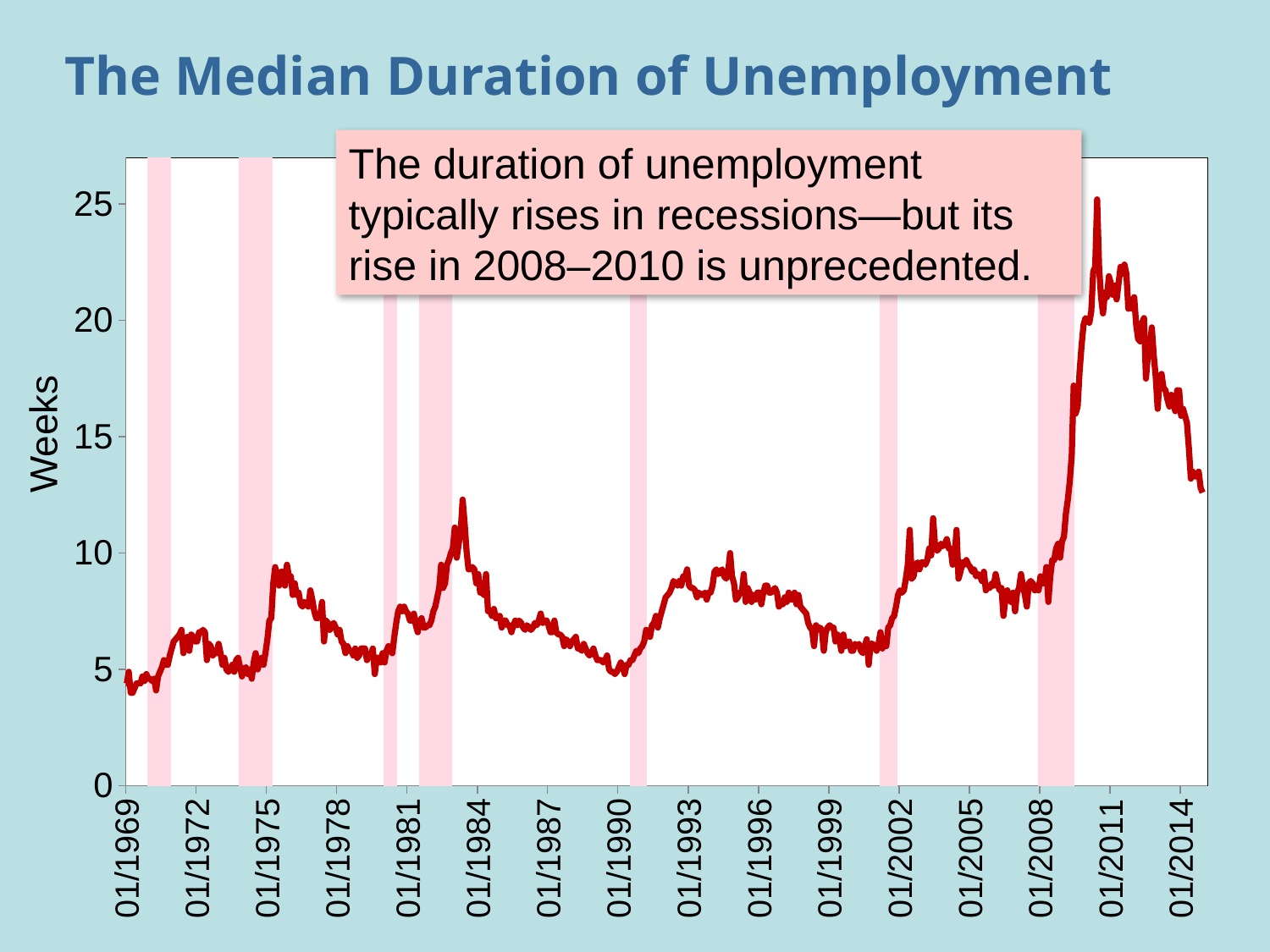
Is the value at 01/1990 greater or less than 10? less Is the value at 01/2005 greater or less than 15? less Is the value at 01/2011 greater or less than 20? greater What is the title of the chart? The Median Duration of Unemployment Which is larger: the peak around 1983 or the peak around 2010? the peak around 2010 Does the line rise or fall between 01/2011 and 01/2014? fall What kind of chart is shown on the slide? line chart What is the label on the vertical axis? Weeks Does the line rise or fall between 01/2008 and 2010? rise Around which year does the line reach its highest value? 2010